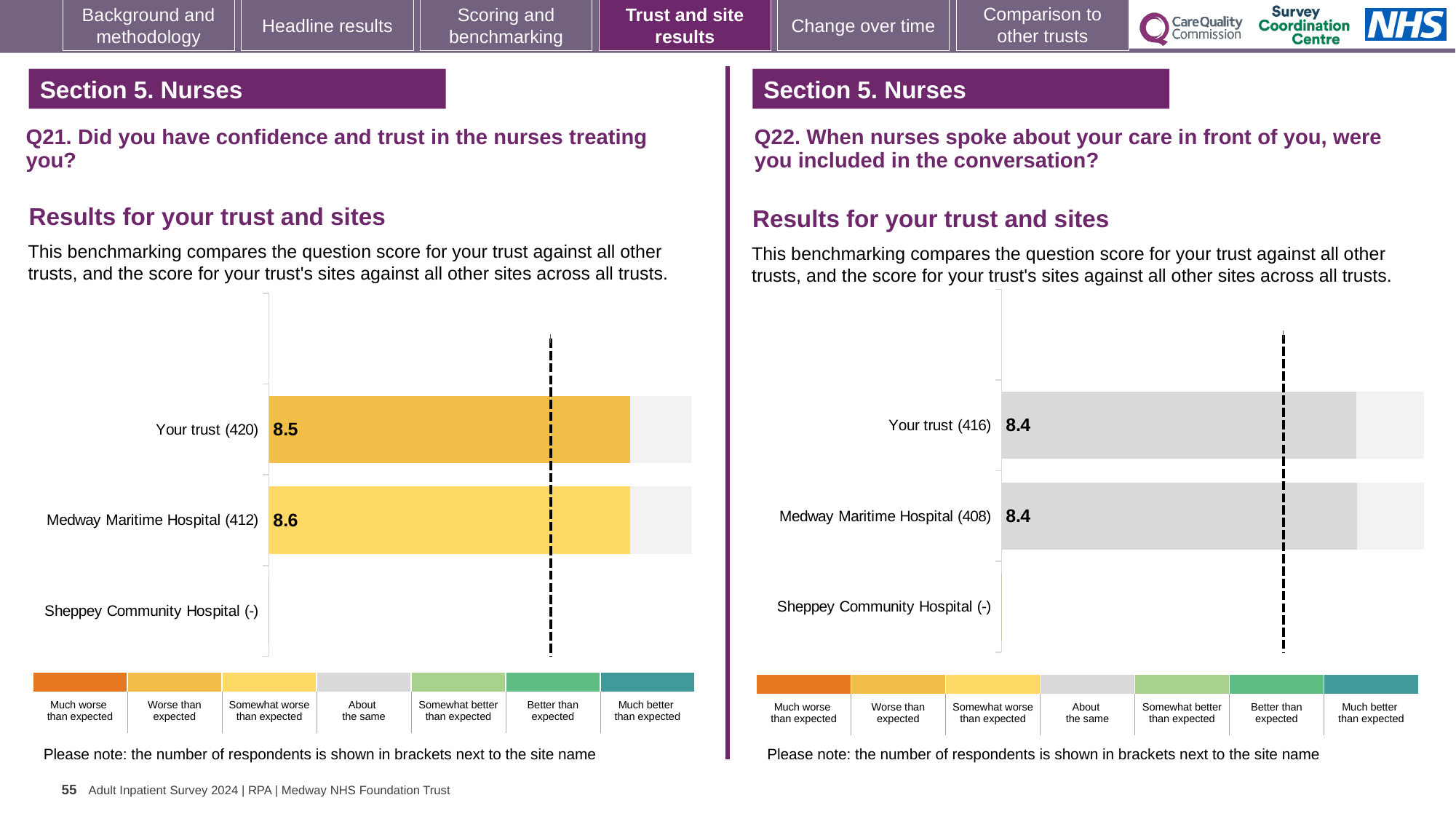
On the Q21 chart (left), which benchmark category does the colour of the Medway Maritime Hospital bar correspond to? Somewhat worse than expected On the Q22 chart (right), which benchmark category does the colour of the Your trust bar correspond to? About the same On the Q21 chart (left), what is the difference between the Medway Maritime Hospital score and the Your trust score? 0.1 On the Q21 chart (left), what is the score for Your trust? 8.5 On the Q21 chart (left), what is the score for Medway Maritime Hospital? 8.6 How many categories are listed on the Q21 chart (left)? 3 On the Q22 chart (right), how many respondents are shown in brackets for Your trust? 416 On the Q22 chart (right), what is the score for Medway Maritime Hospital? 8.4 On the Q21 chart (left), which is larger, the score for Your trust or for Medway Maritime Hospital? Medway Maritime Hospital On the Q22 chart (right), what is the difference between the Your trust score and the Medway Maritime Hospital score? 0 On the Q22 chart (right), what is the score for Your trust? 8.4 What kind of chart is the Q22 chart (right)? Bar chart